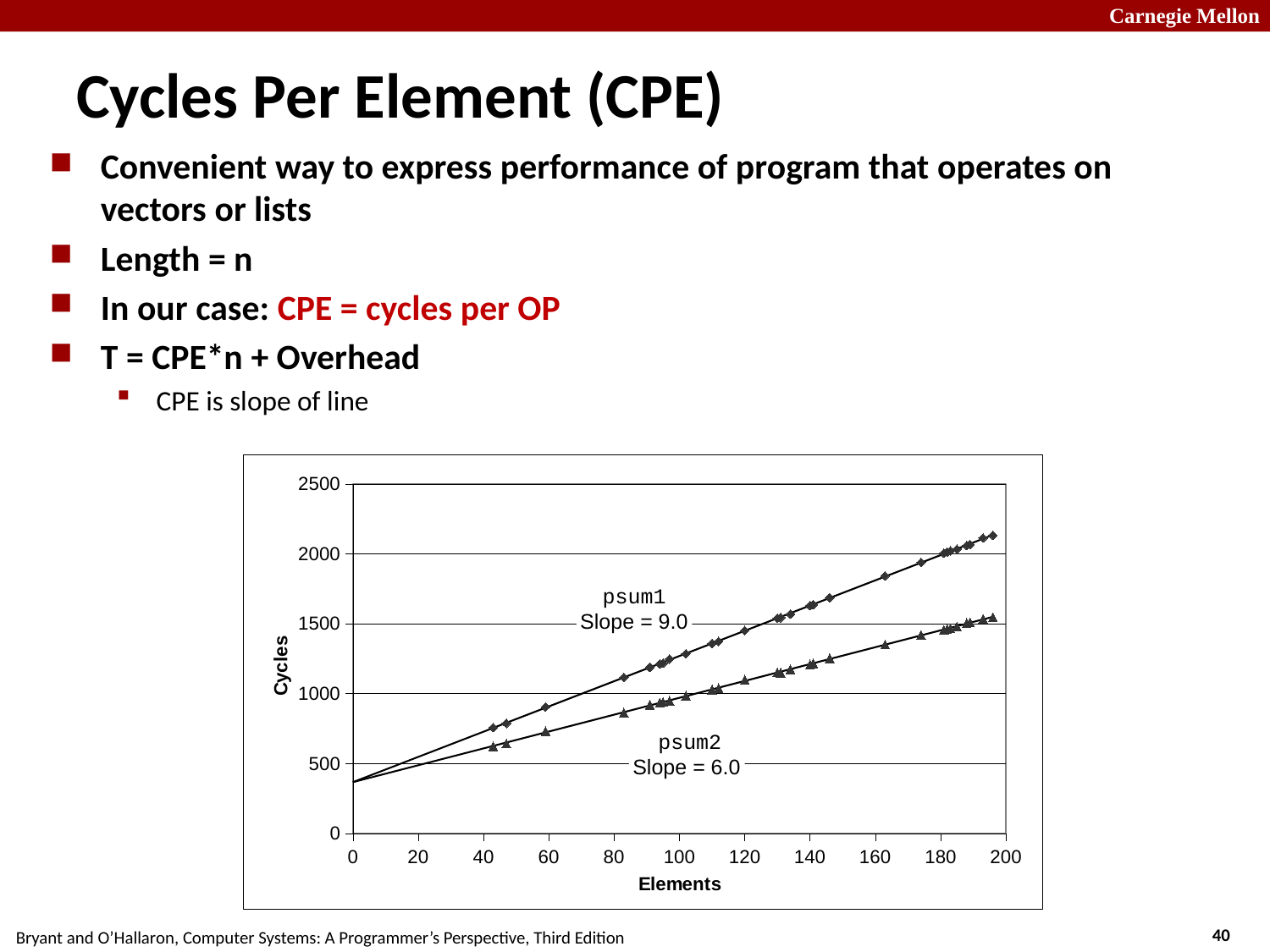
What type of chart is shown on the slide? line chart What is the slope shown for the psum2 line? 6.0 How many data series are plotted on the chart? 2 What is the label of the y axis of the chart? Cycles Is the value for psum2 at about 195 elements greater or less than 2000 cycles? less Do the cycles for psum1 rise or fall as the number of elements increases? rise Is the value for psum1 at about 195 elements greater or less than 2000 cycles? greater Which line has the steeper slope, psum1 or psum2? psum1 Is the value for psum2 at about 100 elements greater or less than 1500 cycles? less What is the label of the x axis of the chart? Elements What is the difference between the slope of psum1 and the slope of psum2? 3.0 What is the slope shown for the psum1 line? 9.0